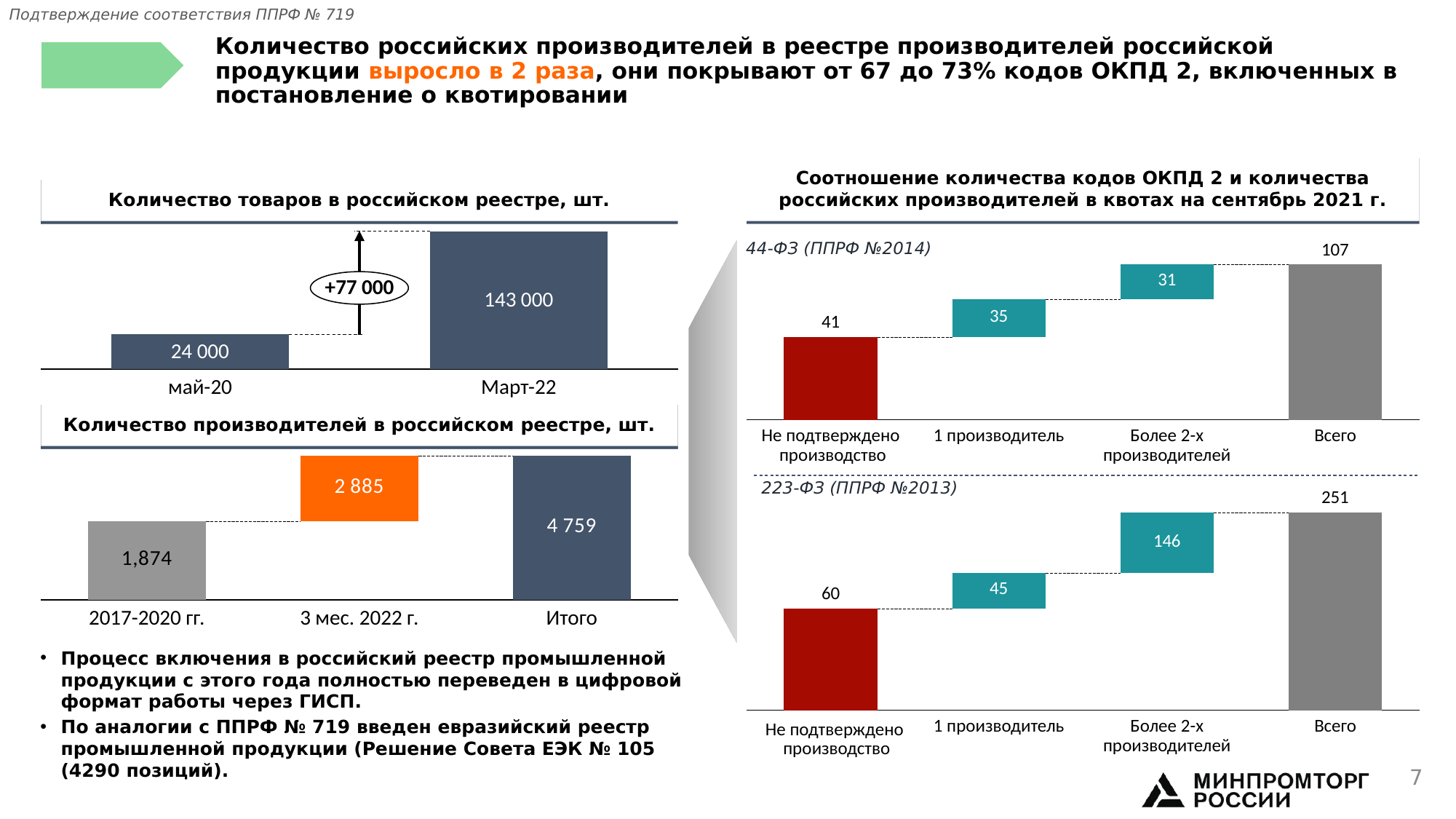
In the chart 'Количество производителей в российском реестре, шт.', what is the value for 3 мес. 2022 г.? 2 885 In the chart 'Количество производителей в российском реестре, шт.', what is the value for 2017-2020 гг.? 1,874 In the chart 'Количество товаров в российском реестре, шт.', what is the value for Март-22? 143 000 What type of chart is 'Количество товаров в российском реестре, шт.'? bar chart In the 44-ФЗ (ППРФ №2014) chart, what is the value for 'Не подтверждено производство'? 41 In the chart 'Количество товаров в российском реестре, шт.', what is the value for май-20? 24 000 In the 223-ФЗ (ППРФ №2013) chart, what is the difference between 'Более 2-х производителей' and '1 производитель'? 101 In the chart 'Количество производителей в российском реестре, шт.', how many bars are shown? 3 In the chart 'Количество производителей в российском реестре, шт.', what is the value for Итого? 4 759 In the 44-ФЗ (ППРФ №2014) chart, what is the value for Всего? 107 In the 223-ФЗ (ППРФ №2013) chart, which category has the highest value apart from Всего? Более 2-х производителей In the chart 'Количество товаров в российском реестре, шт.', what increase is shown in the annotation between май-20 and Март-22? +77 000